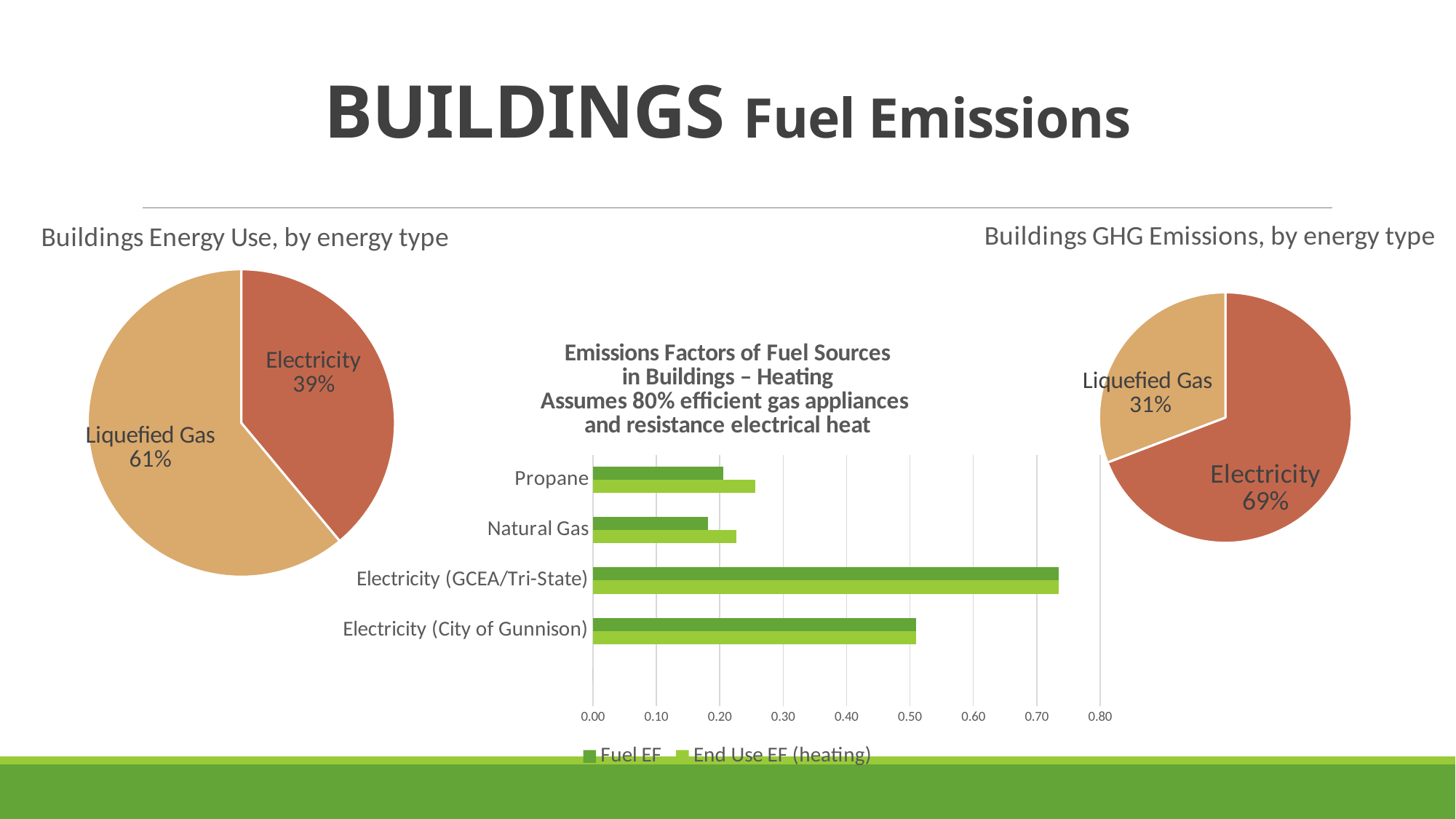
How many fuel source categories are shown in the Emissions Factors of Fuel Sources in Buildings – Heating chart? 4 In the Buildings Energy Use, by energy type pie chart, what share does Liquefied Gas have? 61% In the Buildings GHG Emissions, by energy type pie chart, what share does Liquefied Gas have? 31% What kind of chart is the Emissions Factors of Fuel Sources in Buildings – Heating chart? Bar chart In the Emissions Factors of Fuel Sources in Buildings – Heating chart, is the Fuel EF value for Electricity (City of Gunnison) greater or less than 0.40? greater In the Buildings GHG Emissions, by energy type pie chart, what share does Electricity have? 69% In the Buildings Energy Use, by energy type pie chart, what share does Electricity have? 39% In the Emissions Factors of Fuel Sources in Buildings – Heating chart, is the Fuel EF value for Propane greater or less than 0.30? less In the Emissions Factors of Fuel Sources in Buildings – Heating chart, which fuel source has the highest Fuel EF? Electricity (GCEA/Tri-State) How many series does the legend of the Emissions Factors of Fuel Sources in Buildings – Heating chart list? 2 In the Buildings Energy Use, by energy type pie chart, how many percentage points larger is the Liquefied Gas share than the Electricity share? 22 In the Buildings GHG Emissions, by energy type pie chart, which energy type has the largest slice? Electricity